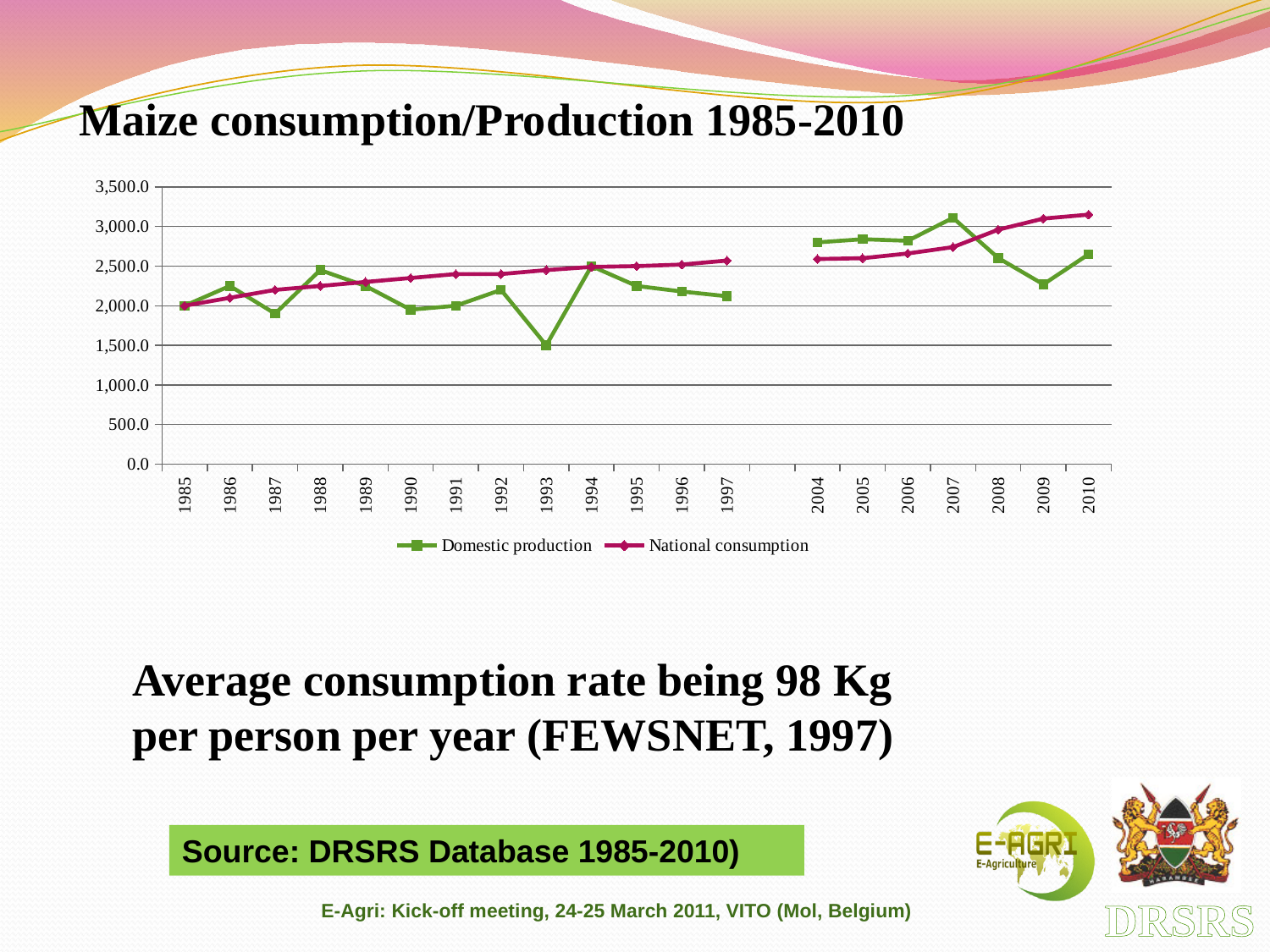
In which year is Domestic production at its lowest? 1993 Is the value for National consumption in 2010 greater or less than 3,000.0? greater Is the value for Domestic production in 1993 greater or less than 2,000.0? less How many series does the legend list? 2 How many years are labelled on the x axis? 20 What kind of chart is shown on the slide? Line chart In which year is National consumption at its highest? 2010 In 1993, which is larger: Domestic production or National consumption? National consumption Does National consumption generally rise or fall from 1985 to 2010? Rise In which year is Domestic production at its highest? 2007 Which series is drawn in green with square markers? Domestic production Is the value for Domestic production in 2007 greater or less than 3,000.0? greater